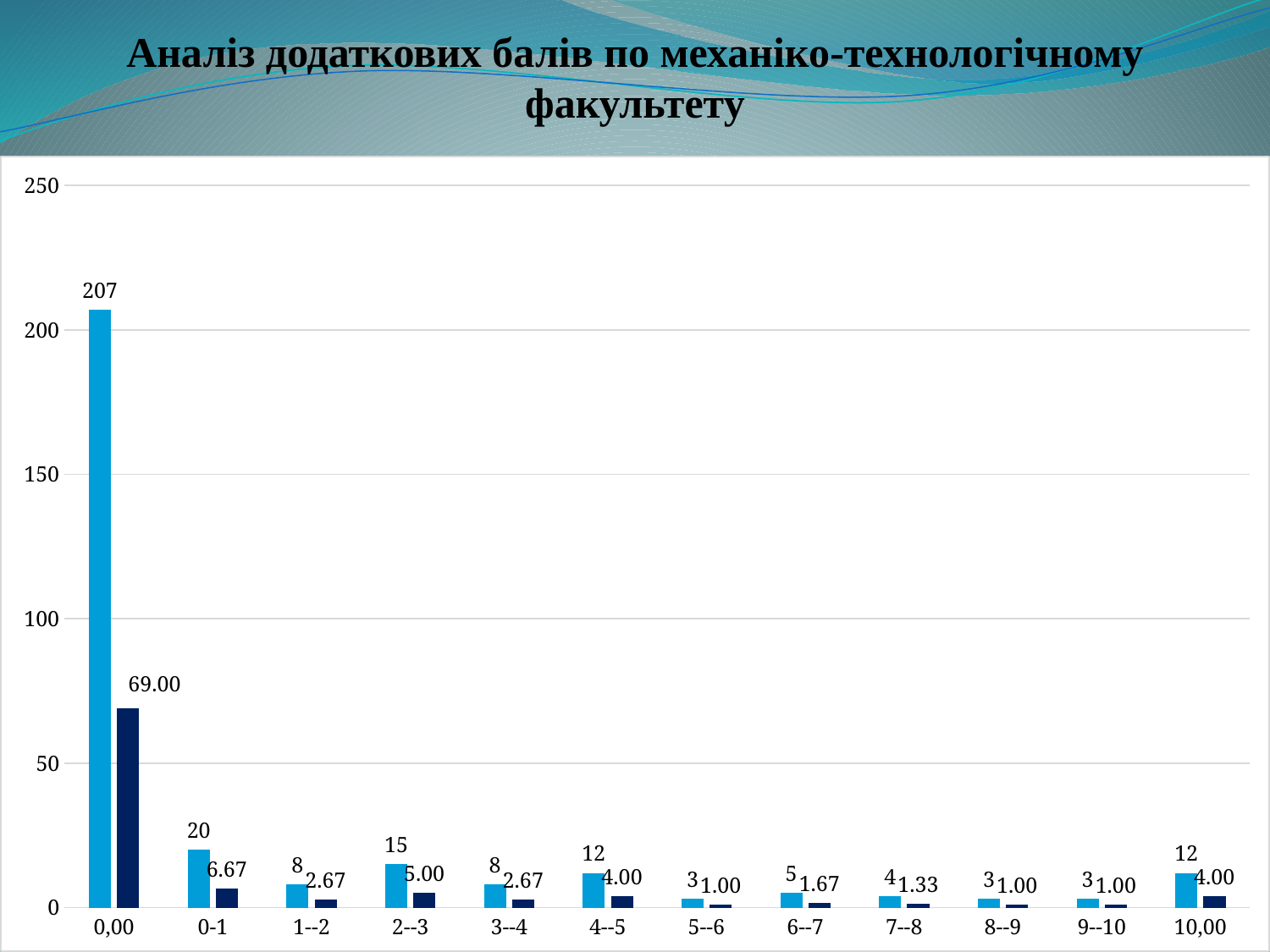
How many categories are shown on the x axis? 12 Is the value of the light blue bar for 0,00 greater or less than 200? greater What is the difference between the light blue bar values for 0-1 and 2--3? 5 What is the value of the dark blue bar for the category 0-1? 6.67 What is the title of the chart? Аналіз додаткових балів по механіко-технологічному факультету What is the value of the light blue bar for the category 0,00? 207 Which is larger: the light blue bar for 4--5 or the light blue bar for 6--7? 4--5 What is the value of the dark blue bar for the category 10,00? 4.00 Which category has the highest light blue bar? 0,00 What is the value of the light blue bar for the category 2--3? 15 What is the value of the dark blue bar for the category 0,00? 69.00 What kind of chart is shown on the slide? bar chart